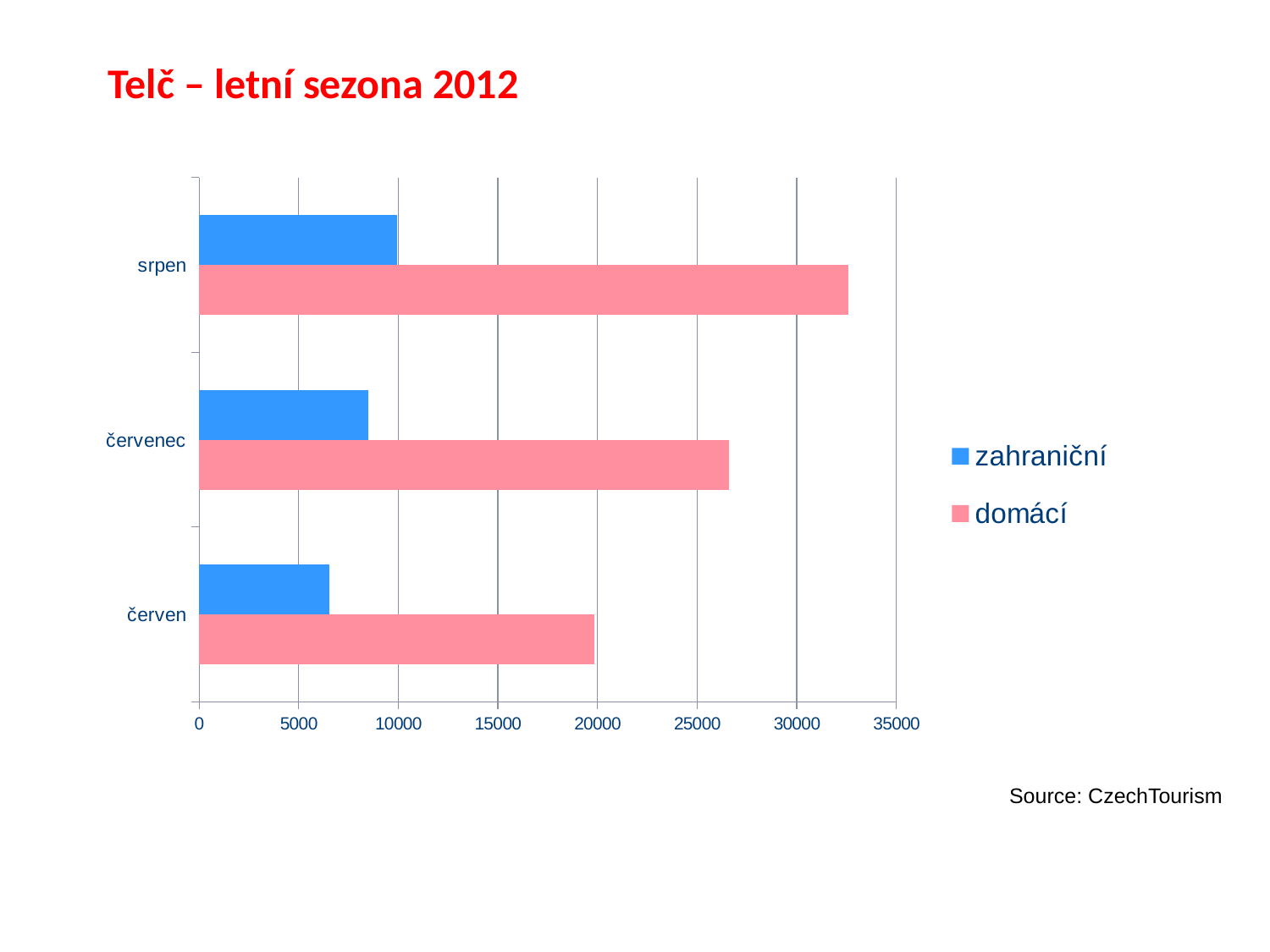
What kind of chart is shown on the slide? bar chart Which is larger in srpen: zahraniční or domácí? domácí Is the value for zahraniční in červenec greater or less than 10000? less Do the domácí values rise or fall from červen to srpen? rise Which month has the lowest value for zahraniční? červen Is the value for domácí in srpen greater or less than 30000? greater How many series does the legend list? 2 Is the value for domácí in červenec greater or less than 25000? greater Which month has the highest value for domácí? srpen How many months (categories) are shown on the chart? 3 What is the title of the slide? Telč – letní sezona 2012